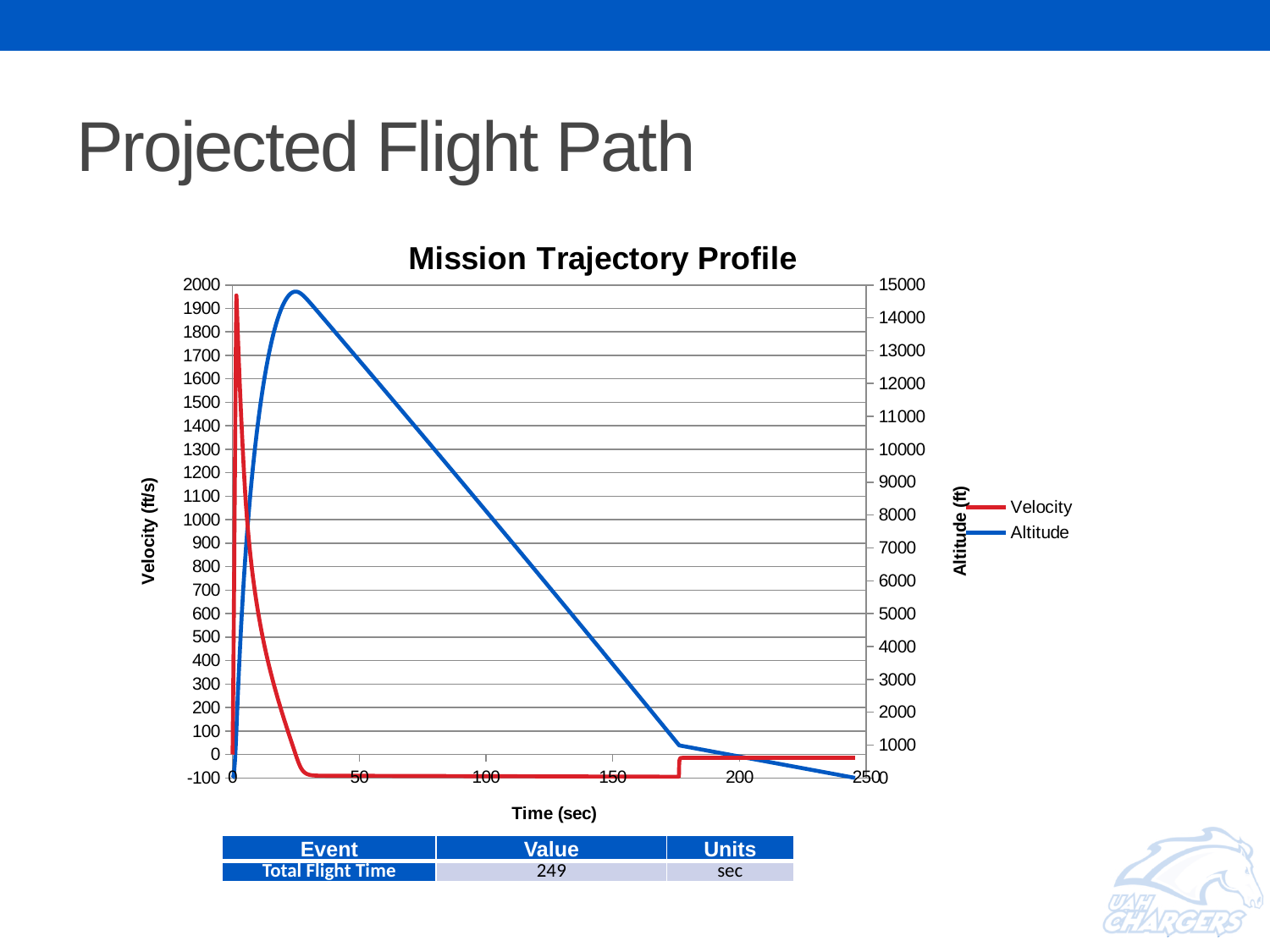
What kind of chart is the Mission Trajectory Profile? line chart After reaching its peak, does the Altitude series rise or fall as time increases? fall What is the label of the x axis of the Mission Trajectory Profile chart? Time (sec) Which series reaches its peak earlier in time, Velocity or Altitude? Velocity Is the peak value of the Velocity series greater or less than 1500? greater Is the Altitude value at 150 seconds greater or less than 6000? less What are the two series named in the legend of the Mission Trajectory Profile chart? Velocity and Altitude Is the Velocity value at 100 seconds greater or less than 500? less How many series does the legend of the Mission Trajectory Profile chart list? 2 According to the table below the chart, what is the Total Flight Time? 249 sec